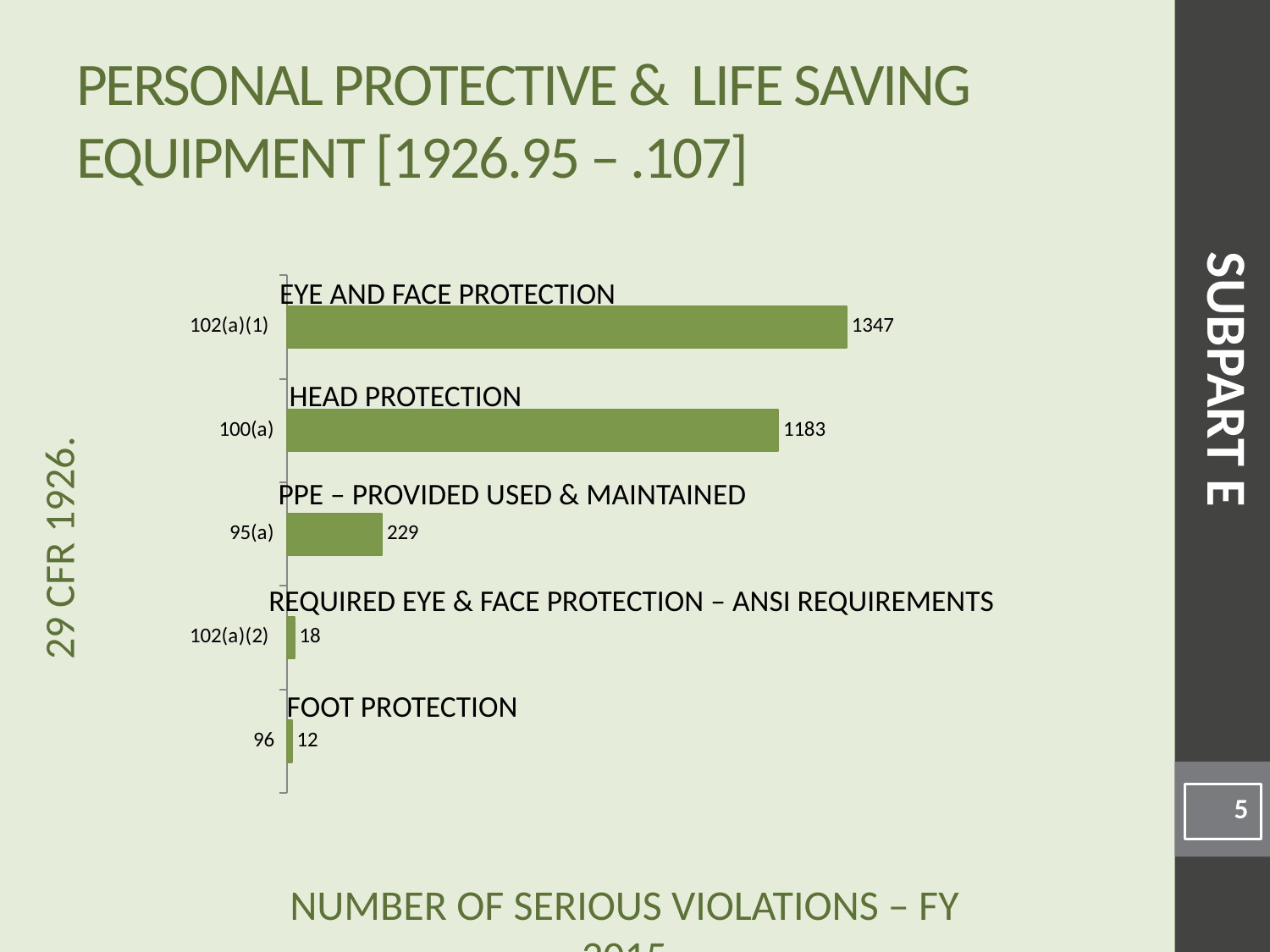
What is the value shown for 95(a), PPE – Provided Used & Maintained? 229 How many categories are plotted in the chart? 5 What is the total of all five values shown in the chart? 2789 What is the number of serious violations for 102(a)(1), Eye and Face Protection? 1347 What is the value shown for 96, Foot Protection? 12 What is the number of serious violations for 100(a), Head Protection? 1183 Which is larger, the value for 102(a)(2) or the value for 96? 102(a)(2) What is the difference between the values for 95(a) and 102(a)(2)? 211 What type of chart is shown on the slide? Bar chart What is the difference between the values for 102(a)(1) and 100(a)? 164 Which category has the lowest number of serious violations? 96 Foot Protection Which category has the highest number of serious violations? 102(a)(1) Eye and Face Protection